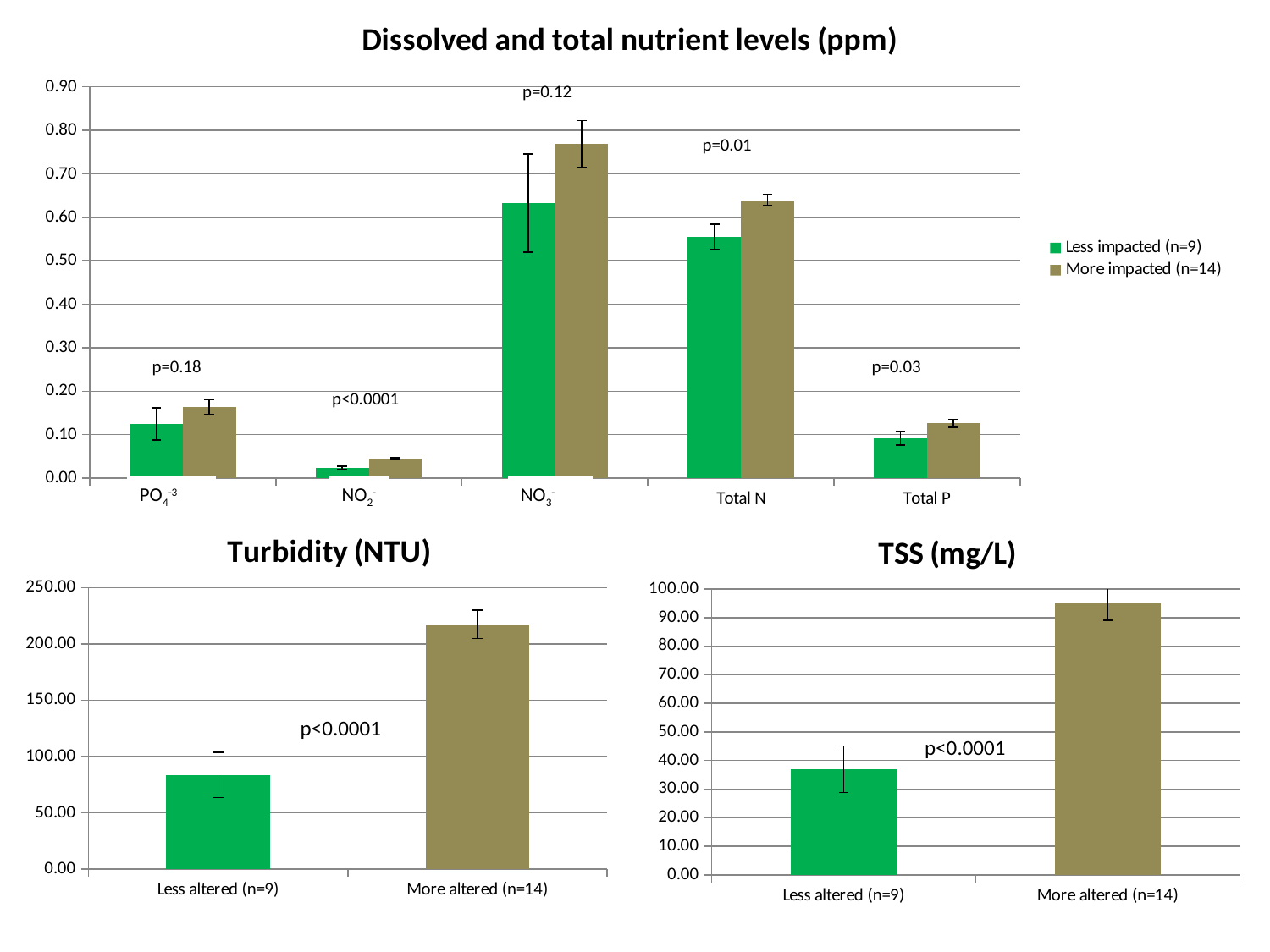
In the 'Dissolved and total nutrient levels (ppm)' chart, which category has the lowest value for the Less impacted (n=9) series? NO2- How many categories are shown on the x axis of the 'Dissolved and total nutrient levels (ppm)' chart? 5 In the 'Turbidity (NTU)' chart, is the value for More altered (n=14) greater or less than 200.00? greater In the 'Turbidity (NTU)' chart, is the value for Less altered (n=9) greater or less than 100.00? less What p-value is printed on the 'TSS (mg/L)' chart? p<0.0001 In the 'Dissolved and total nutrient levels (ppm)' chart, is the More impacted (n=14) value for NO3- greater or less than 0.70? greater In the 'Dissolved and total nutrient levels (ppm)' chart, for Total N, which series has the larger value: Less impacted (n=9) or More impacted (n=14)? More impacted (n=14) What type of chart is the 'Dissolved and total nutrient levels (ppm)' chart? bar chart How many series does the legend of the 'Dissolved and total nutrient levels (ppm)' chart list? 2 In the 'Dissolved and total nutrient levels (ppm)' chart, which category has the highest value for the More impacted (n=14) series? NO3-